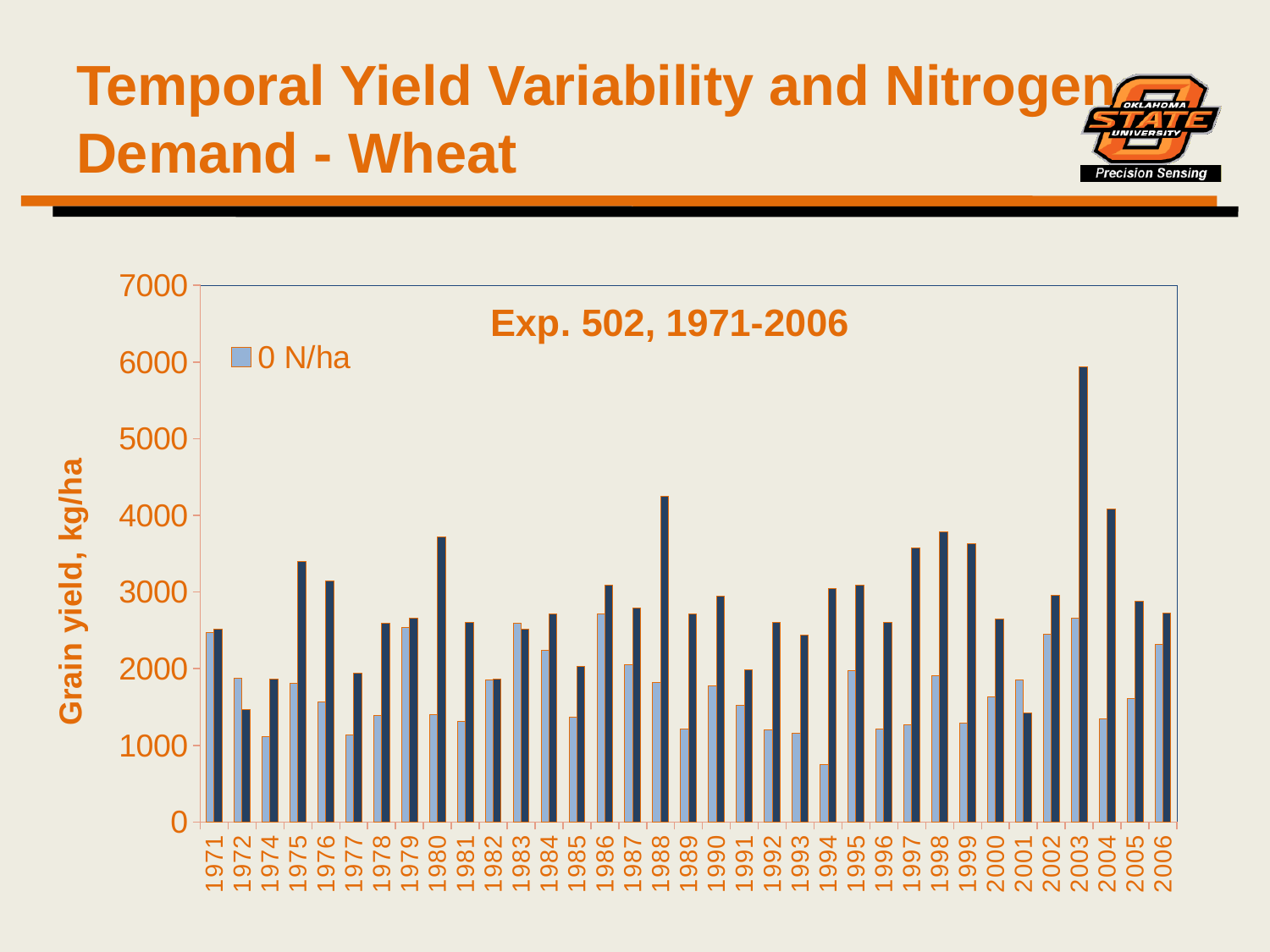
Which year has the larger 0 N/ha value, 1986 or 1994? 1986 Is the 0 N/ha value for 1971 greater or less than 2000? greater What is the label on the vertical axis of the chart? Grain yield, kg/ha What kind of chart is shown on the slide? bar chart Is the 0 N/ha value for 1994 greater or less than 1000? less In which year is the tallest bar on the chart? 2003 What is the title printed inside the chart? Exp. 502, 1971-2006 How many years are shown along the x axis of the chart? 35 In which year is the lowest 0 N/ha bar on the chart? 1994 Is the dark blue bar for 1988 greater or less than 4000? greater How many series does the chart's legend list? 1